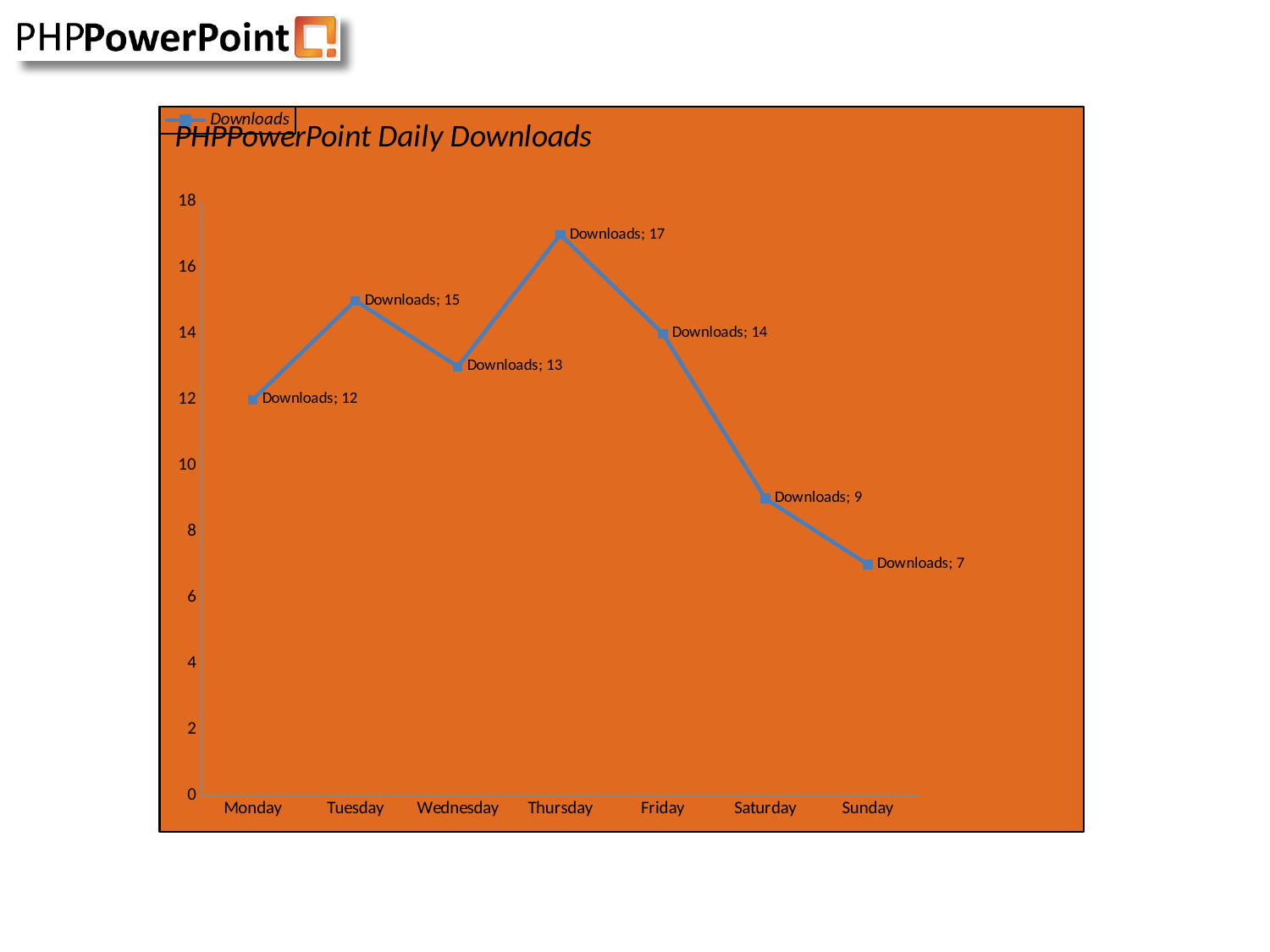
What is the number of downloads on Sunday? 7 How many days are plotted on the chart? 7 Which day has more downloads, Friday or Saturday? Friday What is the number of downloads on Monday? 12 What kind of chart is shown on the slide? Line chart What is the title of the chart? PHPPowerPoint Daily Downloads Which day has the lowest number of downloads? Sunday How many series does the legend list? 1 Which day has the highest number of downloads? Thursday What is the difference in downloads between Tuesday and Wednesday? 2 What is the difference in downloads between Thursday and Sunday? 10 What is the number of downloads on Thursday? 17